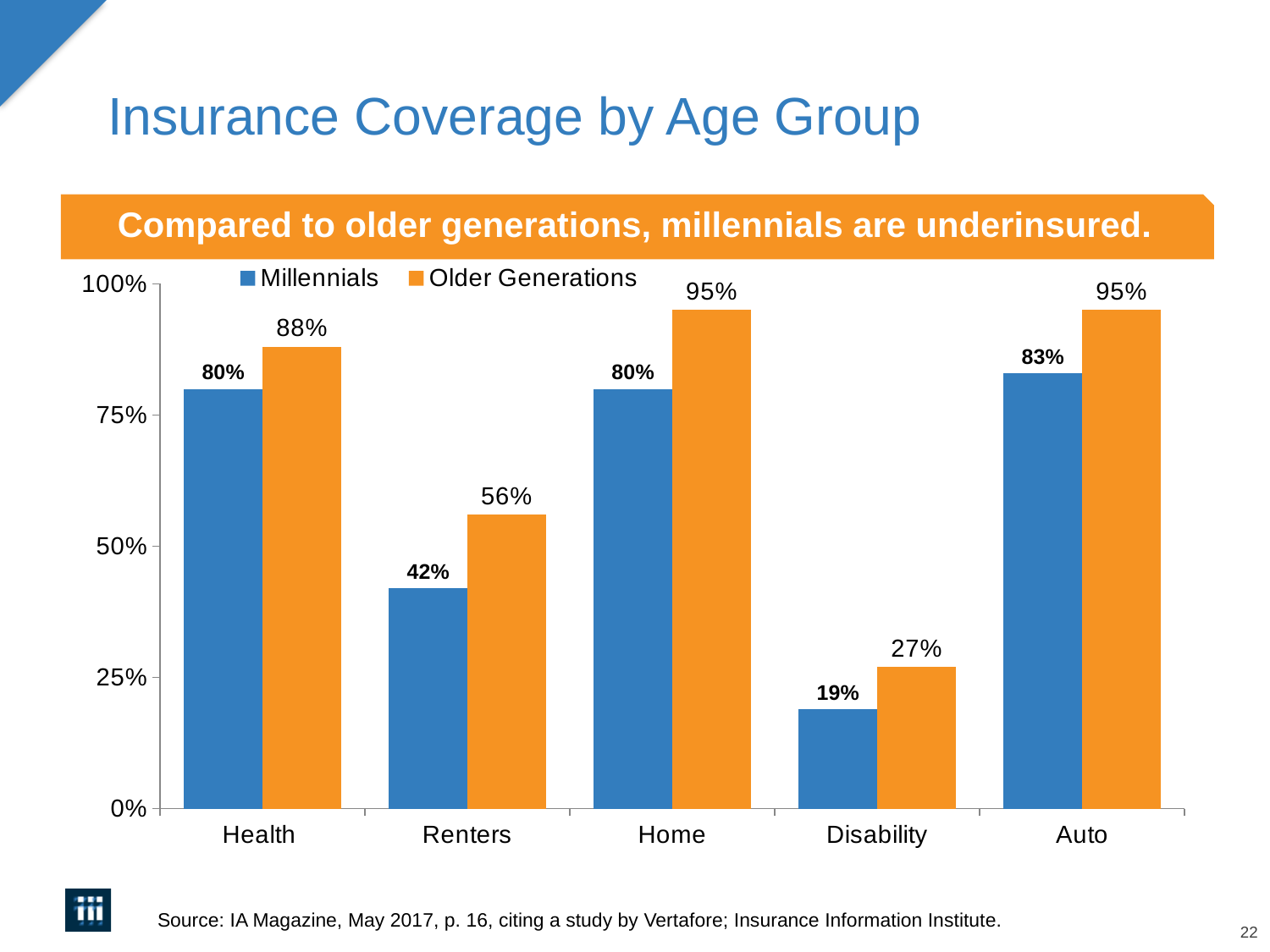
Which category has the lowest Millennials value? Disability How many series does the legend list? 2 What is the Millennials value for Auto? 83% What is the Older Generations value for Disability? 27% What is the Millennials value for Renters? 42% Which category has the highest Millennials value? Auto What is the difference between the Older Generations and Millennials values for Health? 8% Which is larger, the Millennials value for Health or the Millennials value for Renters? Health How many insurance categories are shown on the x axis? 5 What is the difference between the Older Generations and Millennials values for Home? 15% What kind of chart is shown on the slide? Bar chart Is the Older Generations value for Renters greater or less than 50%? greater